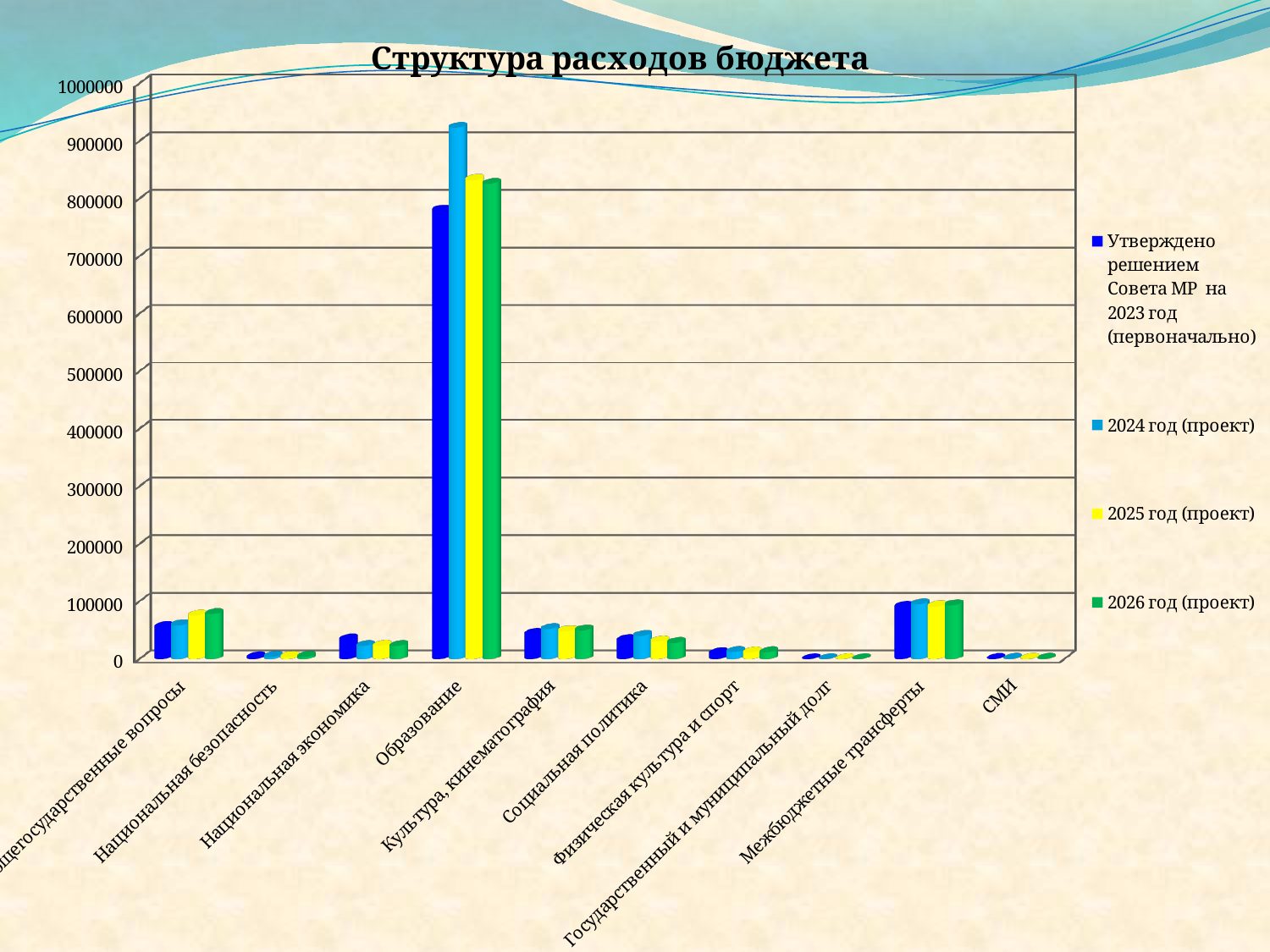
Is the value for Образование in the series Утверждено решением Совета МР на 2023 год (первоначально) greater or less than 700000? greater What is the title of the chart? Структура расходов бюджета Which category has the highest values in the chart? Образование How many series does the legend list? 4 Is the value for Образование in the series 2024 год (проект) greater or less than 900000? greater What colour are the bars for the series 2025 год (проект)? yellow Which is larger in the series 2024 год (проект): Культура, кинематография or Национальная безопасность? Культура, кинематография For the category Образование, which series has the tallest bar? 2024 год (проект) Which is larger in the series 2025 год (проект): Образование or Межбюджетные трансферты? Образование How many categories are shown on the x axis of the chart? 10 What kind of chart is shown on the slide? bar chart